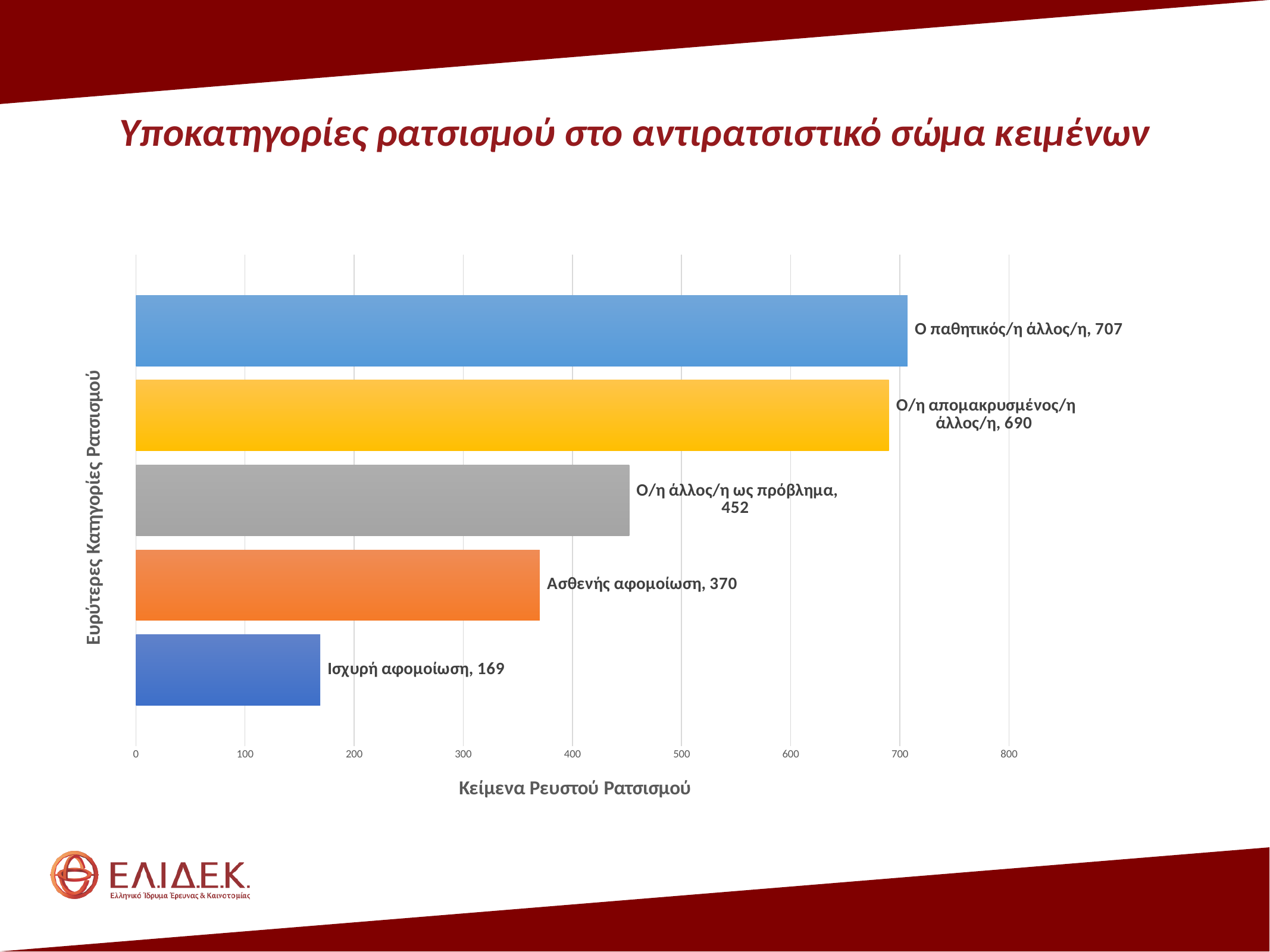
What is the label of the horizontal axis? Κείμενα Ρευστού Ρατσισμού Which is larger, the value for Ο/η άλλος/η ως πρόβλημα or the value for Ισχυρή αφομοίωση? Ο/η άλλος/η ως πρόβλημα What is the value for Ο παθητικός/η άλλος/η? 707 What is the value for Ασθενής αφομοίωση? 370 What is the difference between the values for Ο/η άλλος/η ως πρόβλημα and Ασθενής αφομοίωση? 82 Which category has the lowest value? Ισχυρή αφομοίωση What is the difference between the values for Ο παθητικός/η άλλος/η and Ο/η απομακρυσμένος/η άλλος/η? 17 Is the value for Ο/η απομακρυσμένος/η άλλος/η greater or less than 600? greater What is the value for Ισχυρή αφομοίωση? 169 Which category has the highest value? Ο παθητικός/η άλλος/η How many categories are shown in the chart? 5 What kind of chart is shown on the slide? bar chart